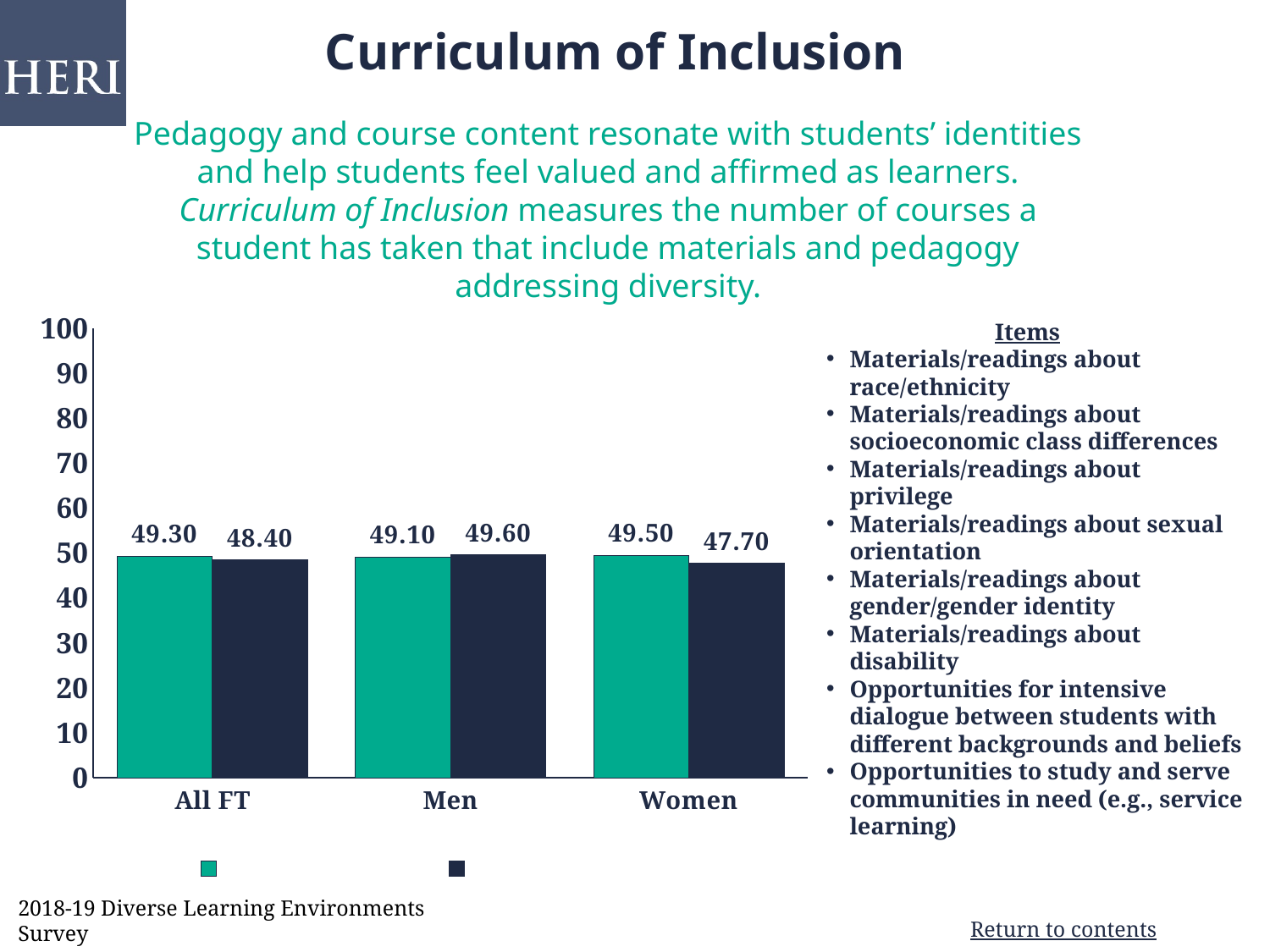
Which category has the highest dark navy bar? Men What is the value of the teal bar for All FT? 49.30 What is the value of the dark navy bar for Women? 47.70 For Women, which bar is larger, the teal bar or the dark navy bar? teal How many series does the legend show? 2 What is the difference between the dark navy bars for Men and Women? 1.90 Which category has the lowest dark navy bar? Women What is the value of the dark navy bar for Men? 49.60 What kind of chart is shown on the slide? bar chart How many categories are shown on the x axis? 3 What is the value of the teal bar for Women? 49.50 What is the difference between the teal and dark navy bars for Women? 1.80